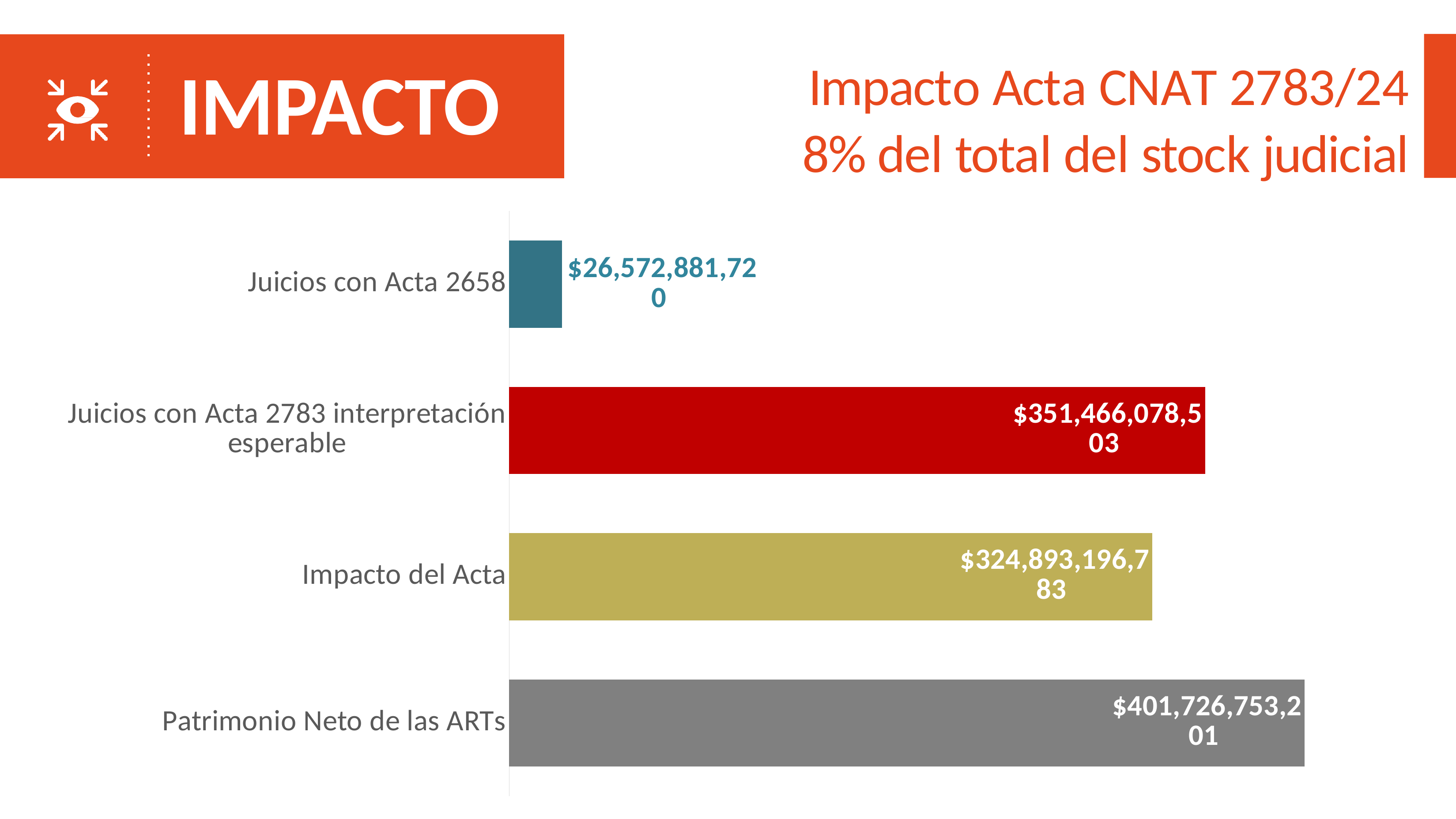
What is the difference between Juicios con Acta 2783 interpretación esperable and Juicios con Acta 2658? $324,893,196,783 What is the difference between Patrimonio Neto de las ARTs and Juicios con Acta 2783 interpretación esperable? $50,260,674,698 Which category has the lowest value? Juicios con Acta 2658 Which category has the highest value? Patrimonio Neto de las ARTs What colour is the bar for Impacto del Acta? Yellow (olive) How many categories are shown in the chart? 4 What is the value for Impacto del Acta? $324,893,196,783 Which is larger, Impacto del Acta or Juicios con Acta 2783 interpretación esperable? Juicios con Acta 2783 interpretación esperable What is the value for Patrimonio Neto de las ARTs? $401,726,753,201 What is the value for Juicios con Acta 2783 interpretación esperable? $351,466,078,503 What kind of chart is shown on the slide? Bar chart What is the value for Juicios con Acta 2658? $26,572,881,720